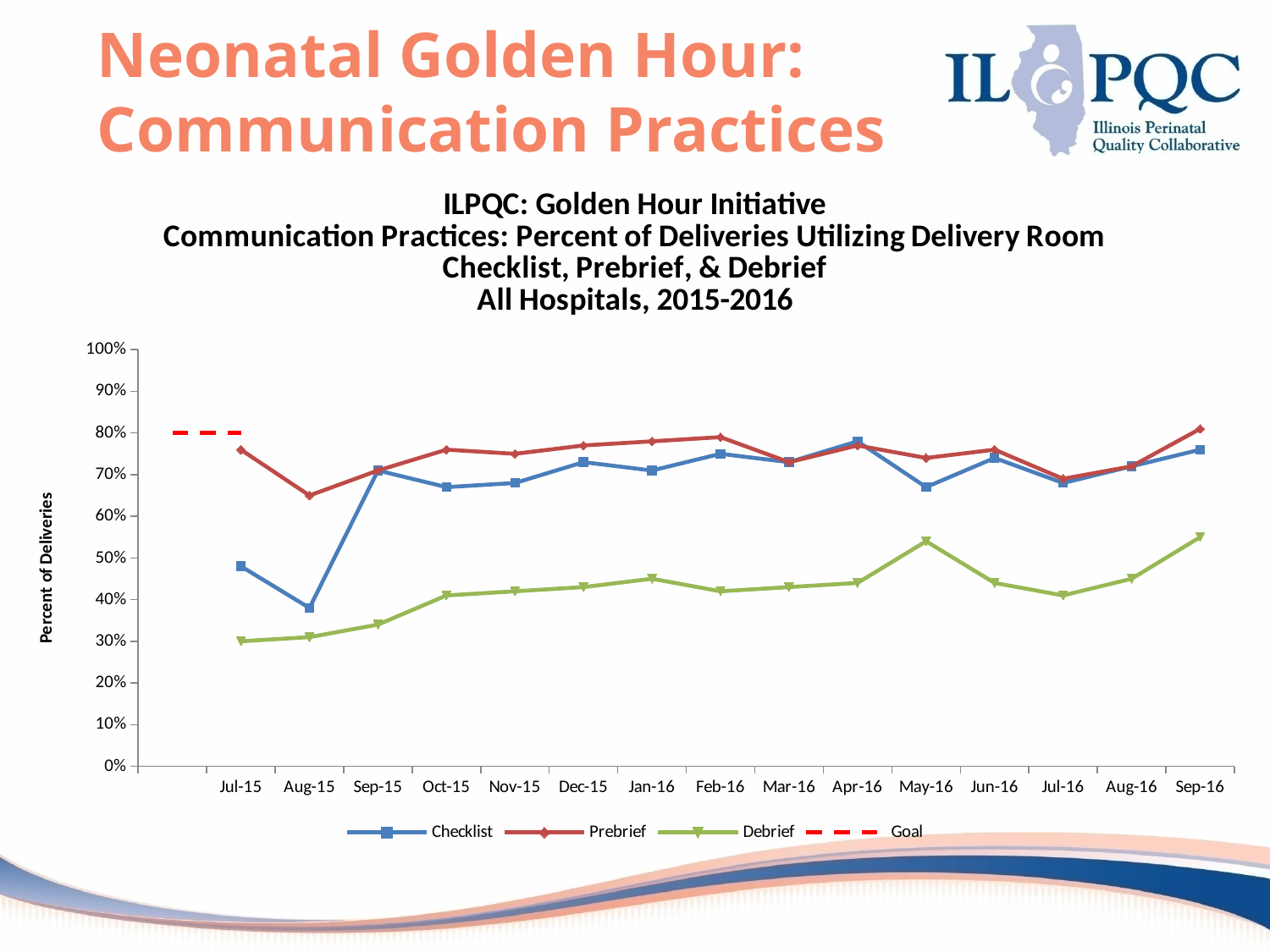
What kind of chart is shown on the slide? line chart In Jan-16, which is higher, Prebrief or Debrief? Prebrief How many entries does the legend list? 4 Is the Debrief value for May-16 greater or less than 50%? greater How many months are shown along the x axis? 15 What value does the Goal line sit at? 80% Is the Checklist value for Aug-15 greater or less than 50%? less What is the label on the y axis? Percent of Deliveries In which month is the Checklist series at its lowest? Aug-15 Is the Debrief value for Jul-15 greater or less than 40%? less Does the Debrief series rise or fall from Jul-15 to Jan-16? rise